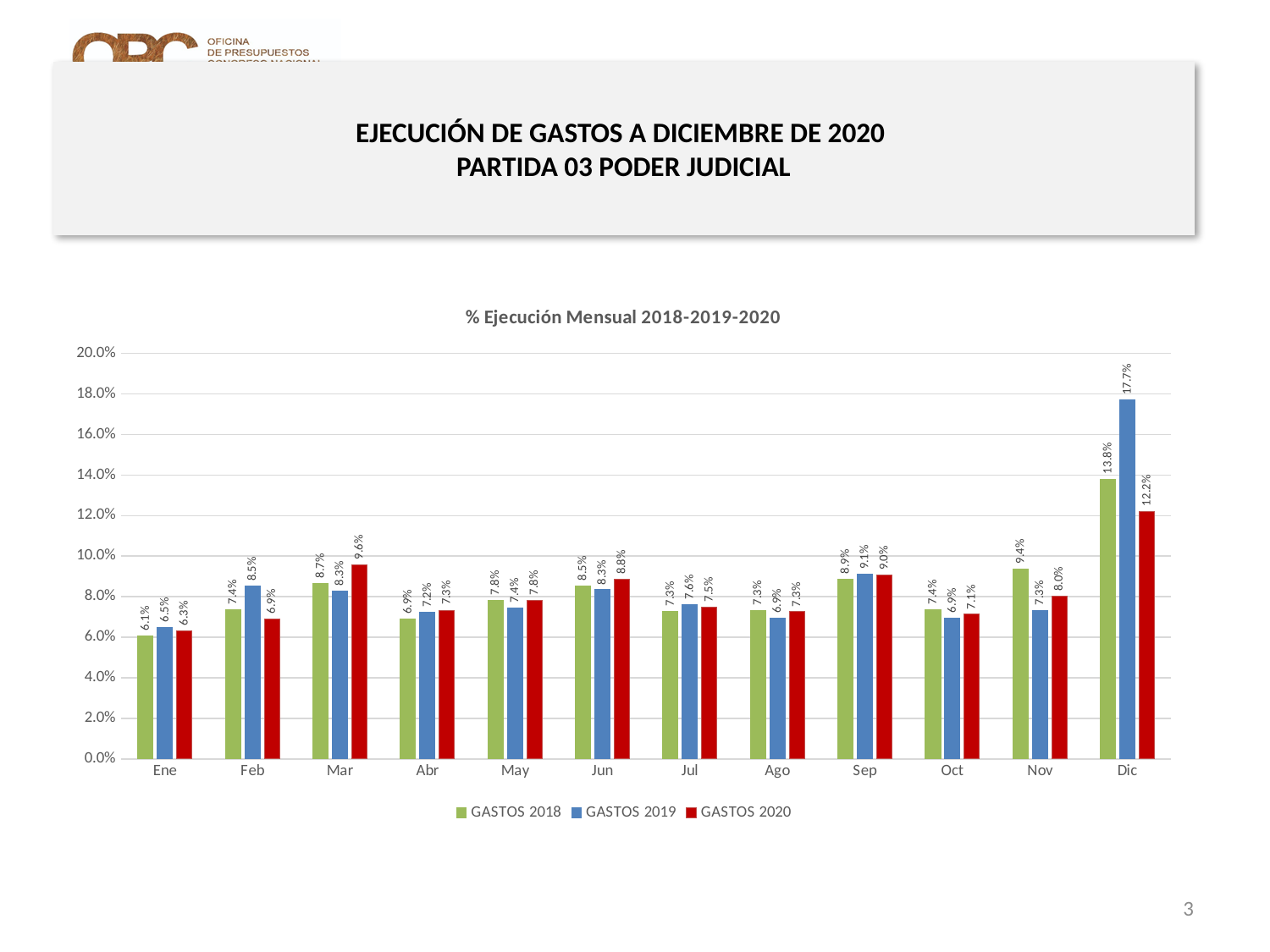
Which month has the highest value for GASTOS 2018? Dic Which month has the lowest value for GASTOS 2020? Ene What is the title of the chart? % Ejecución Mensual 2018-2019-2020 What is the difference between GASTOS 2019 and GASTOS 2020 in Dic? 5.5% What is the value for GASTOS 2019 in Dic? 17.7% Which is larger in Feb, GASTOS 2019 or GASTOS 2020? GASTOS 2019 What kind of chart is shown on the slide? bar chart How many months are shown on the x axis? 12 Is the value for GASTOS 2018 in Dic greater or less than 12.0%? greater What is the value for GASTOS 2020 in Mar? 9.6% What is the value for GASTOS 2018 in Nov? 9.4% How many series does the legend list? 3